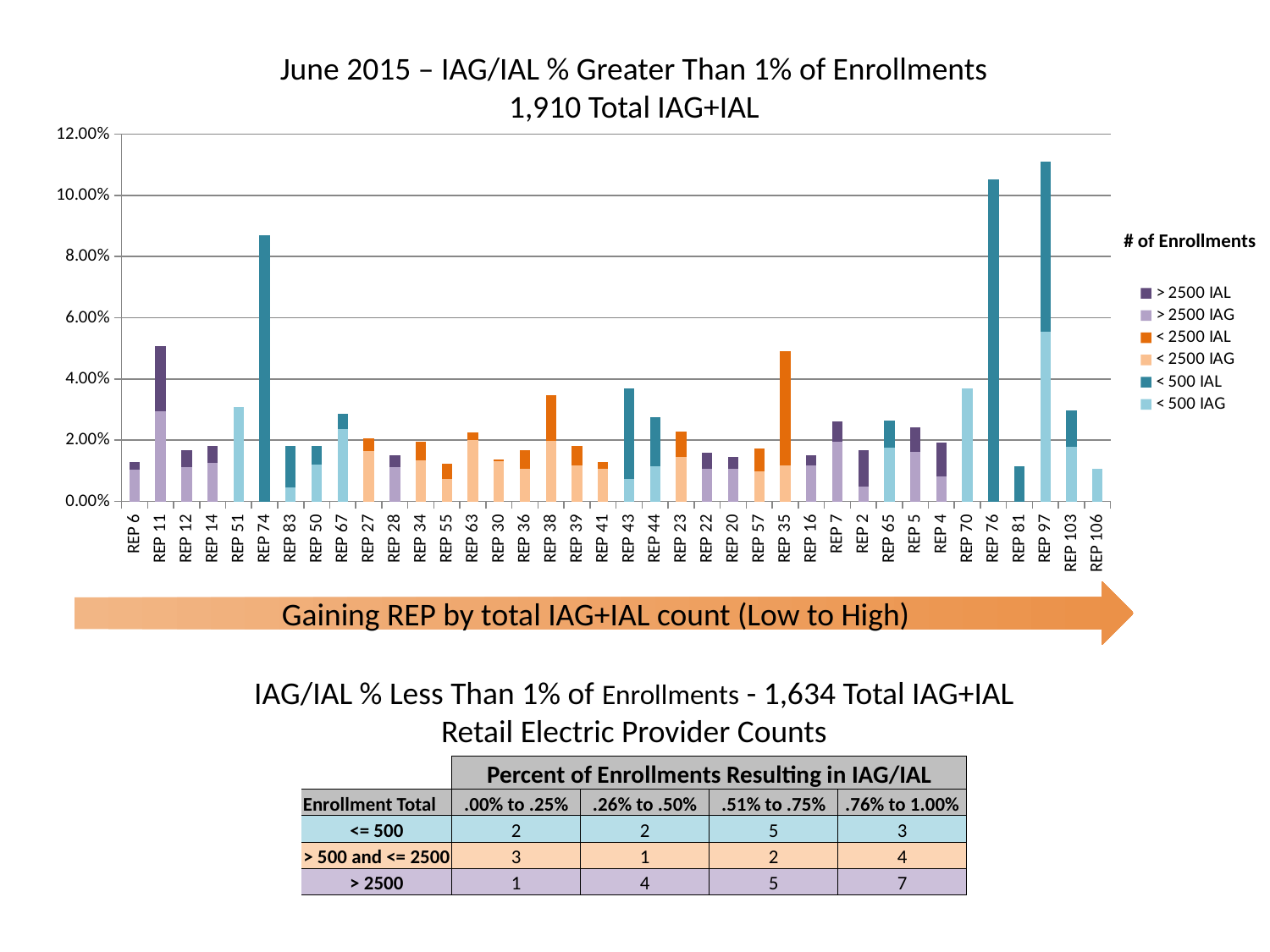
Is the value for REP 74 greater or less than 8.00%? greater What is the title of the chart? June 2015 – IAG/IAL % Greater Than 1% of Enrollments 1,910 Total IAG+IAL How many REP categories are plotted along the x axis? 38 What type of chart is shown on the slide? Stacked bar chart Is the value for REP 6 greater or less than 2.00%? less Is the value for REP 76 greater or less than 10.00%? greater What is the title shown above the chart legend? # of Enrollments Which REP has the highest total IAG/IAL percentage? REP 97 Which has the larger total value, REP 74 or REP 11? REP 74 How many series does the chart legend list? 6 Which has the larger total value, REP 35 or REP 43? REP 35